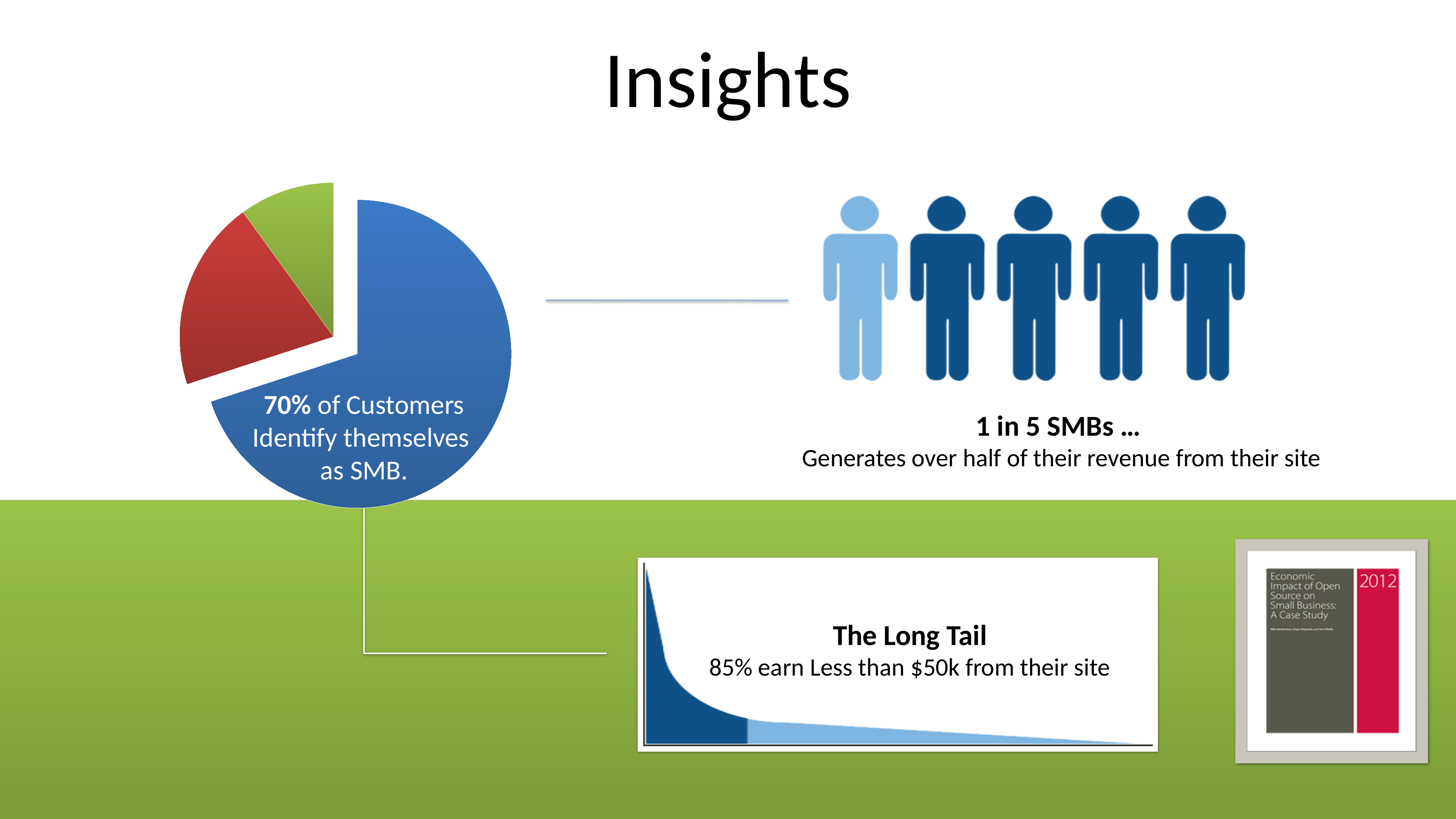
In the pie chart, which slice is larger, the red slice or the green slice? the red slice In the pie chart, is the blue slice greater or less than 50% of the pie? greater In the pie chart, what colour is the slice labelled 70%? blue In the pie chart, which slice is the largest? the blue slice (70% of Customers Identify themselves as SMB) What is the title of the chart at the bottom of the slide? The Long Tail In the people pictogram on the right, how many figures are shown? 5 In the pie chart, how many slices are there? 3 According to The Long Tail chart, what percentage earn less than $50k from their site? 85% In The Long Tail chart, do the values rise or fall from left to right? fall What kind of chart is shown on the left of the slide? pie chart In the pie chart, what share of customers identify themselves as SMB? 70% In the pie chart, which slice is the smallest? the green slice